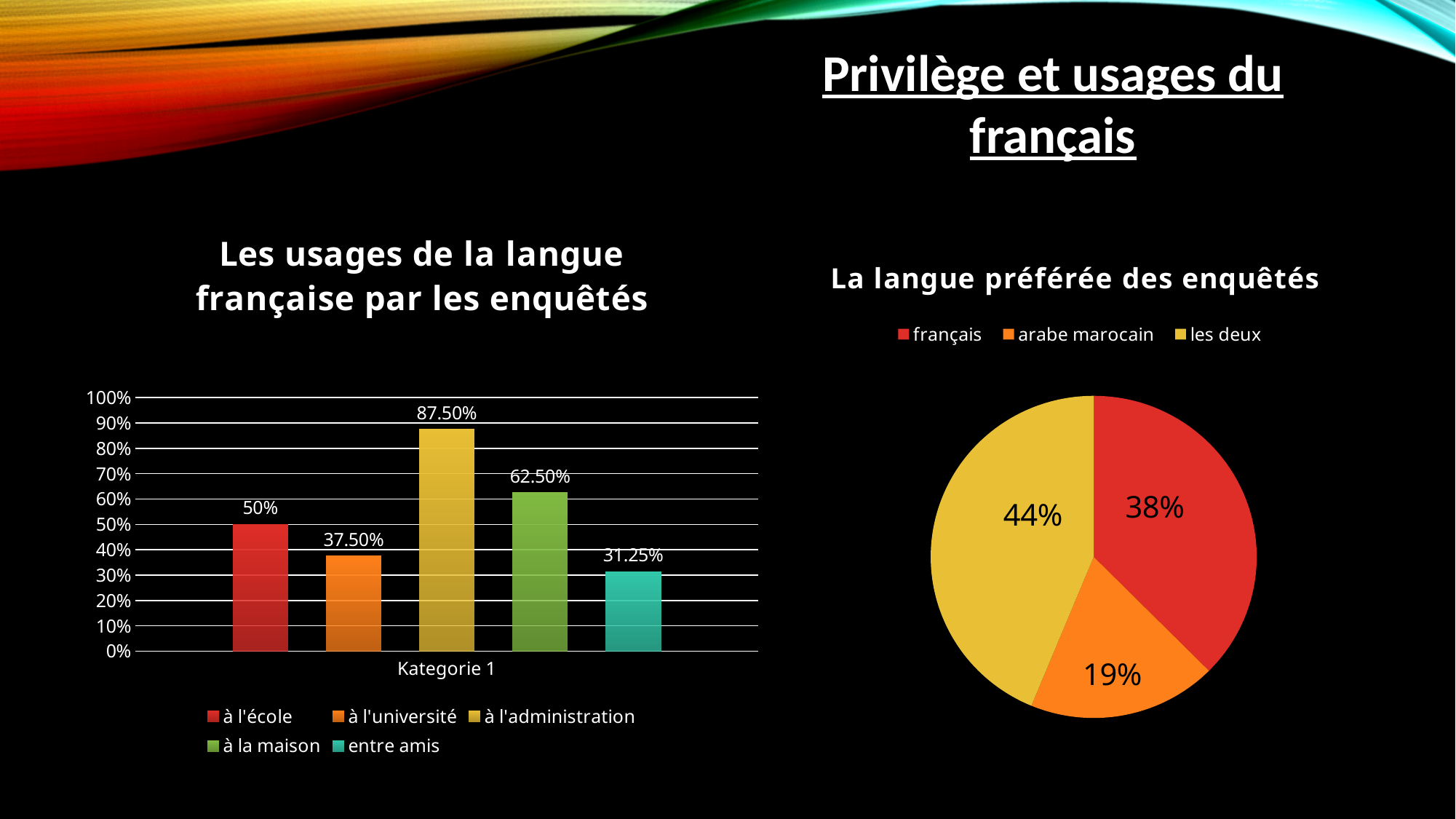
In the chart 'Les usages de la langue française par les enquêtés', what is the difference between 'à l'administration' and 'à la maison'? 25% In the chart 'La langue préférée des enquêtés', what share is 'arabe marocain'? 19% In the chart 'Les usages de la langue française par les enquêtés', what is the value for 'à l'administration'? 87.50% In the chart 'Les usages de la langue française par les enquêtés', which is larger: 'à l'école' or 'à l'université'? à l'école How many series does the legend of the chart 'Les usages de la langue française par les enquêtés' list? 5 In the chart 'Les usages de la langue française par les enquêtés', which series has the lowest value? entre amis In the chart 'La langue préférée des enquêtés', what is the difference between 'les deux' and 'français'? 6% What kind of chart is 'Les usages de la langue française par les enquêtés'? bar chart In the chart 'La langue préférée des enquêtés', which slice is the largest? les deux In the chart 'Les usages de la langue française par les enquêtés', which series has the highest value? à l'administration What kind of chart is 'La langue préférée des enquêtés'? pie chart In the chart 'Les usages de la langue française par les enquêtés', what is the value for 'entre amis'? 31.25%